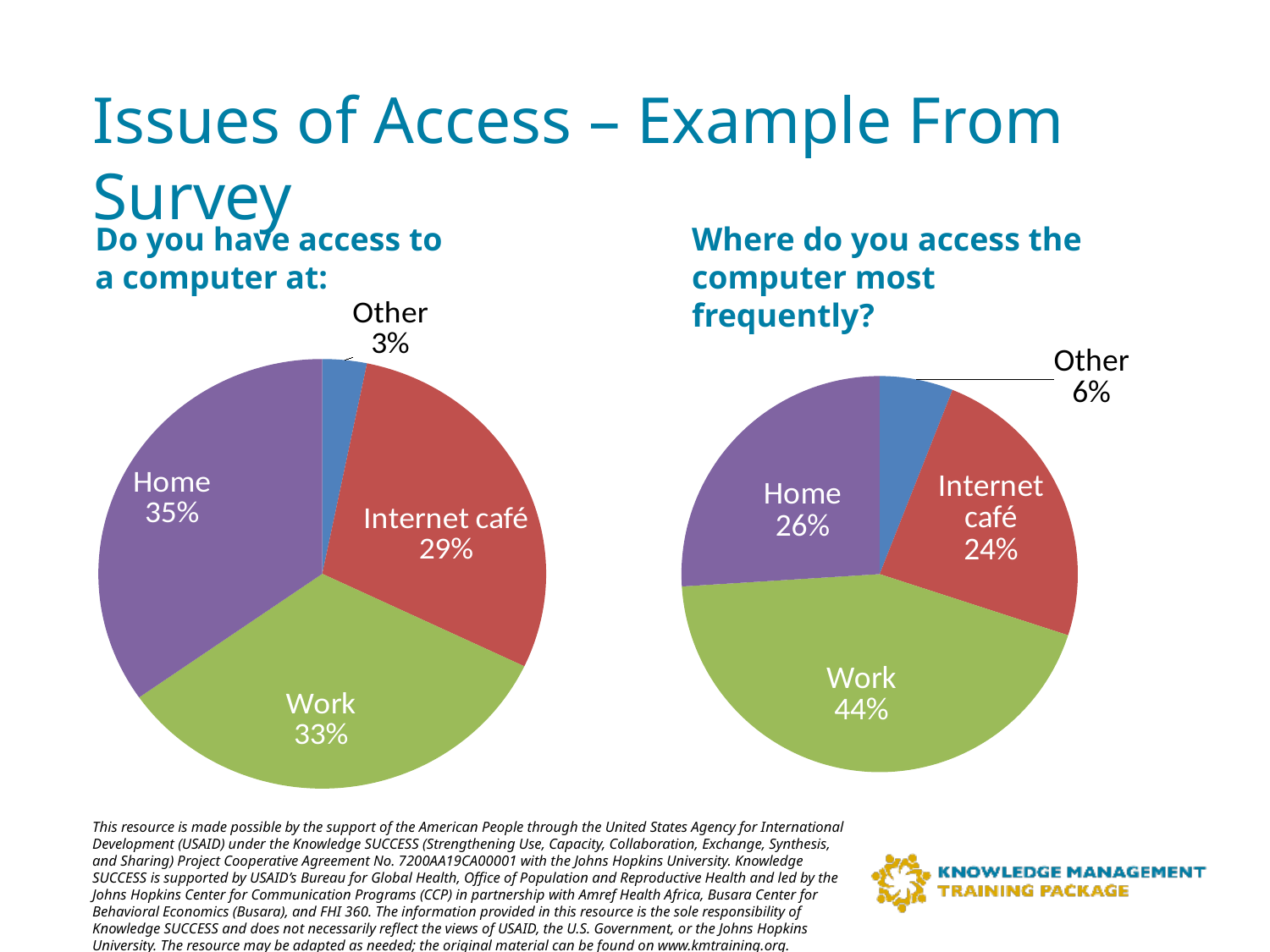
In the left pie chart ('Do you have access to a computer at:'), what is the difference between the Home and Work percentages? 2% What type of chart is used on the right side of the slide ('Where do you access the computer most frequently?')? Pie chart In the left pie chart ('Do you have access to a computer at:'), what percentage is shown for Internet café? 29% How many slices does the left pie chart ('Do you have access to a computer at:') have? 4 In the right pie chart ('Where do you access the computer most frequently?'), what is the difference between the Work and Other percentages? 38% In the right pie chart ('Where do you access the computer most frequently?'), what percentage is shown for Work? 44% In the left pie chart ('Do you have access to a computer at:'), which category has the largest share? Home In the right pie chart ('Where do you access the computer most frequently?'), which is larger, Home or Internet café? Home What colour is the Work slice in the left pie chart ('Do you have access to a computer at:')? Green In the right pie chart ('Where do you access the computer most frequently?'), what percentage is shown for Other? 6% In the right pie chart ('Where do you access the computer most frequently?'), which category has the smallest share? Other In the left pie chart ('Do you have access to a computer at:'), what percentage is shown for Home? 35%